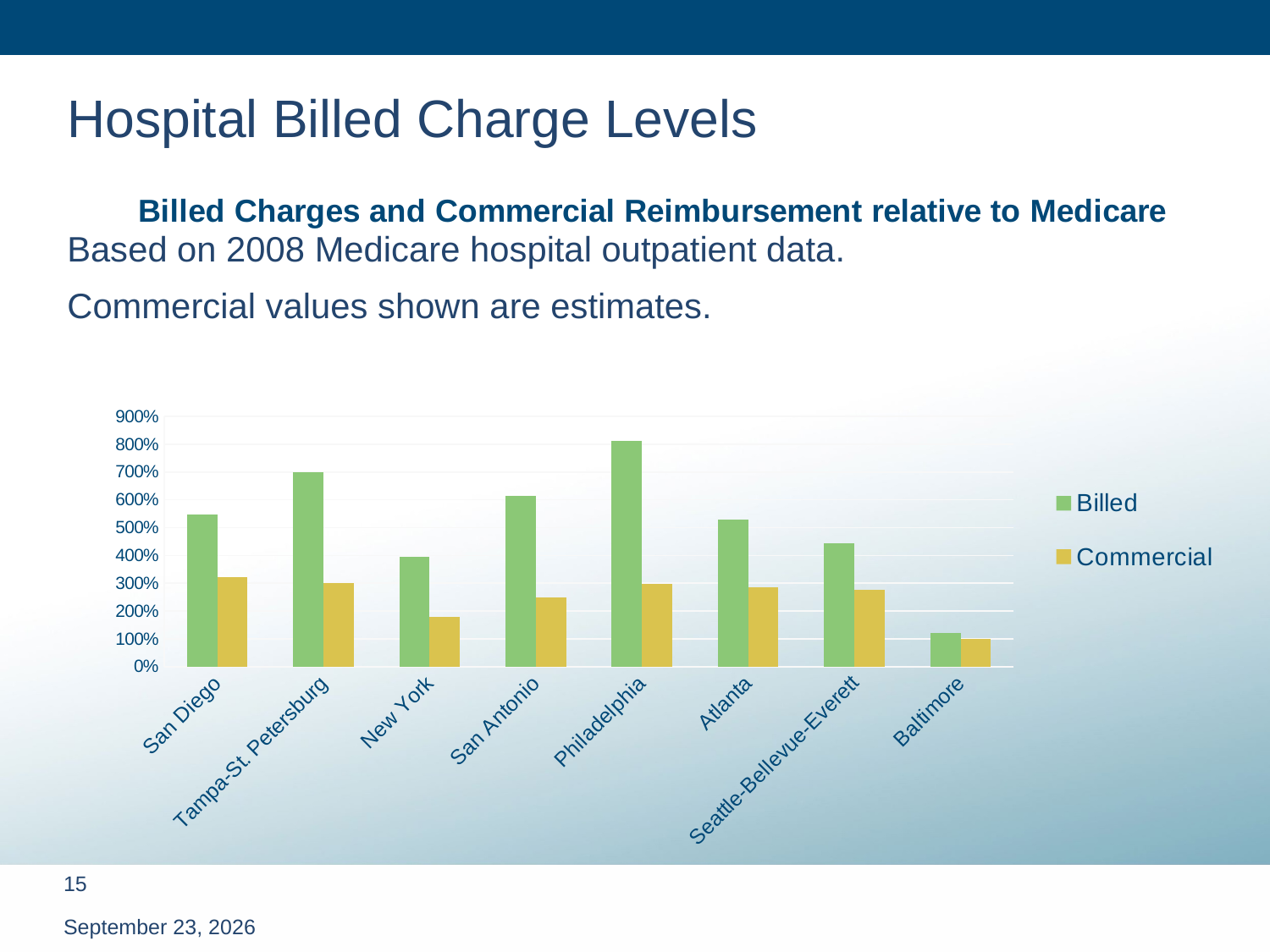
Is the Billed value for Philadelphia greater or less than 700%? greater Which is larger, the Billed value for Tampa-St. Petersburg or the Billed value for San Antonio? Tampa-St. Petersburg Which is larger, the Commercial value for San Antonio or the Commercial value for New York? San Antonio Is the Billed value for Baltimore greater or less than 200%? less Which city has the highest Billed value? Philadelphia Which city has the lowest Billed value? Baltimore Which city has the lowest Commercial value? Baltimore Is the Commercial value for New York greater or less than 200%? less How many cities are shown on the x axis of the chart? 8 What kind of chart is shown on the slide? bar chart What colour are the Commercial bars in the chart? yellow How many series does the legend list? 2